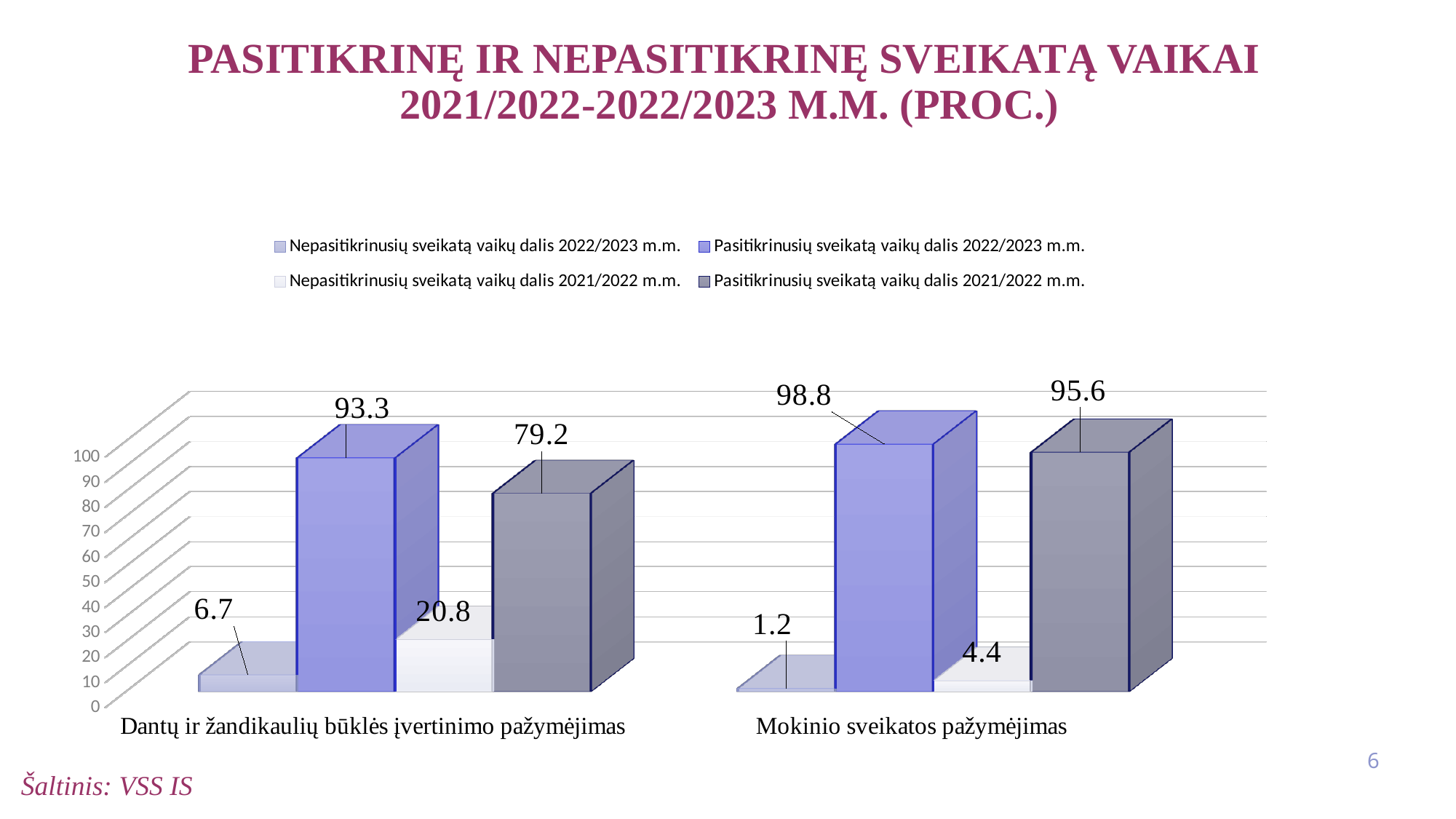
What is the source cited at the bottom of the slide? VSS IS What is the value for 'Pasitikrinusių sveikatą vaikų dalis 2021/2022 m.m.' in the 'Dantų ir žandikaulių būklės įvertinimo pažymėjimas' category? 79.2 What is the value for 'Pasitikrinusių sveikatą vaikų dalis 2022/2023 m.m.' in the 'Dantų ir žandikaulių būklės įvertinimo pažymėjimas' category? 93.3 What is the value for 'Nepasitikrinusių sveikatą vaikų dalis 2022/2023 m.m.' in the 'Mokinio sveikatos pažymėjimas' category? 1.2 Which is larger in the 'Mokinio sveikatos pažymėjimas' category: 'Nepasitikrinusių sveikatą vaikų dalis 2021/2022 m.m.' or 'Nepasitikrinusių sveikatą vaikų dalis 2022/2023 m.m.'? Nepasitikrinusių sveikatą vaikų dalis 2021/2022 m.m. How many categories are shown on the x axis of the chart? 2 How many series does the legend list? 4 What is the value for 'Nepasitikrinusių sveikatą vaikų dalis 2021/2022 m.m.' in the 'Mokinio sveikatos pažymėjimas' category? 4.4 What is the difference between the 'Pasitikrinusių sveikatą vaikų dalis 2022/2023 m.m.' and 'Pasitikrinusių sveikatą vaikų dalis 2021/2022 m.m.' values in the 'Dantų ir žandikaulių būklės įvertinimo pažymėjimas' category? 14.1 Which series has the lowest value in the 'Dantų ir žandikaulių būklės įvertinimo pažymėjimas' category? Nepasitikrinusių sveikatą vaikų dalis 2022/2023 m.m. What kind of chart is shown on the slide? Bar chart Which series has the highest value in the 'Mokinio sveikatos pažymėjimas' category? Pasitikrinusių sveikatą vaikų dalis 2022/2023 m.m.